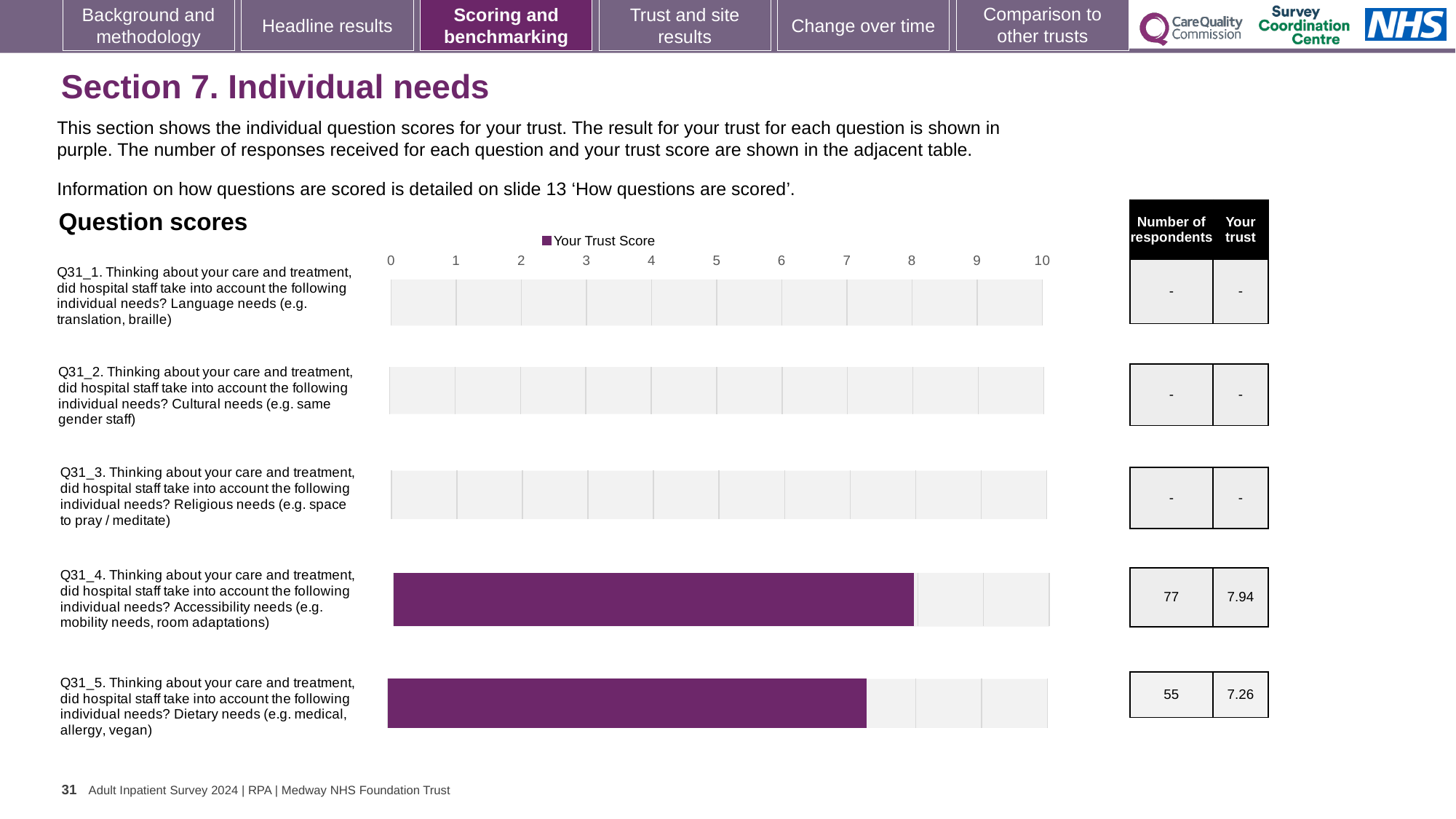
How many respondents answered Q31_5? 55 Which has the larger trust score, Q31_4 or Q31_5? Q31_4 What is the difference between the trust scores for Q31_4 and Q31_5? 0.68 What kind of chart is shown under 'Question scores'? bar chart Which question has the highest trust score on the chart? Q31_4 What is the trust score for Q31_4 (Accessibility needs)? 7.94 What is the trust score for Q31_5 (Dietary needs)? 7.26 Is the trust score for Q31_5 greater or less than 8? less How many questions (categories) are listed on the chart? 5 What is the name of the series shown in the chart legend? Your Trust Score How many series does the chart legend list? 1 How many respondents answered Q31_4? 77